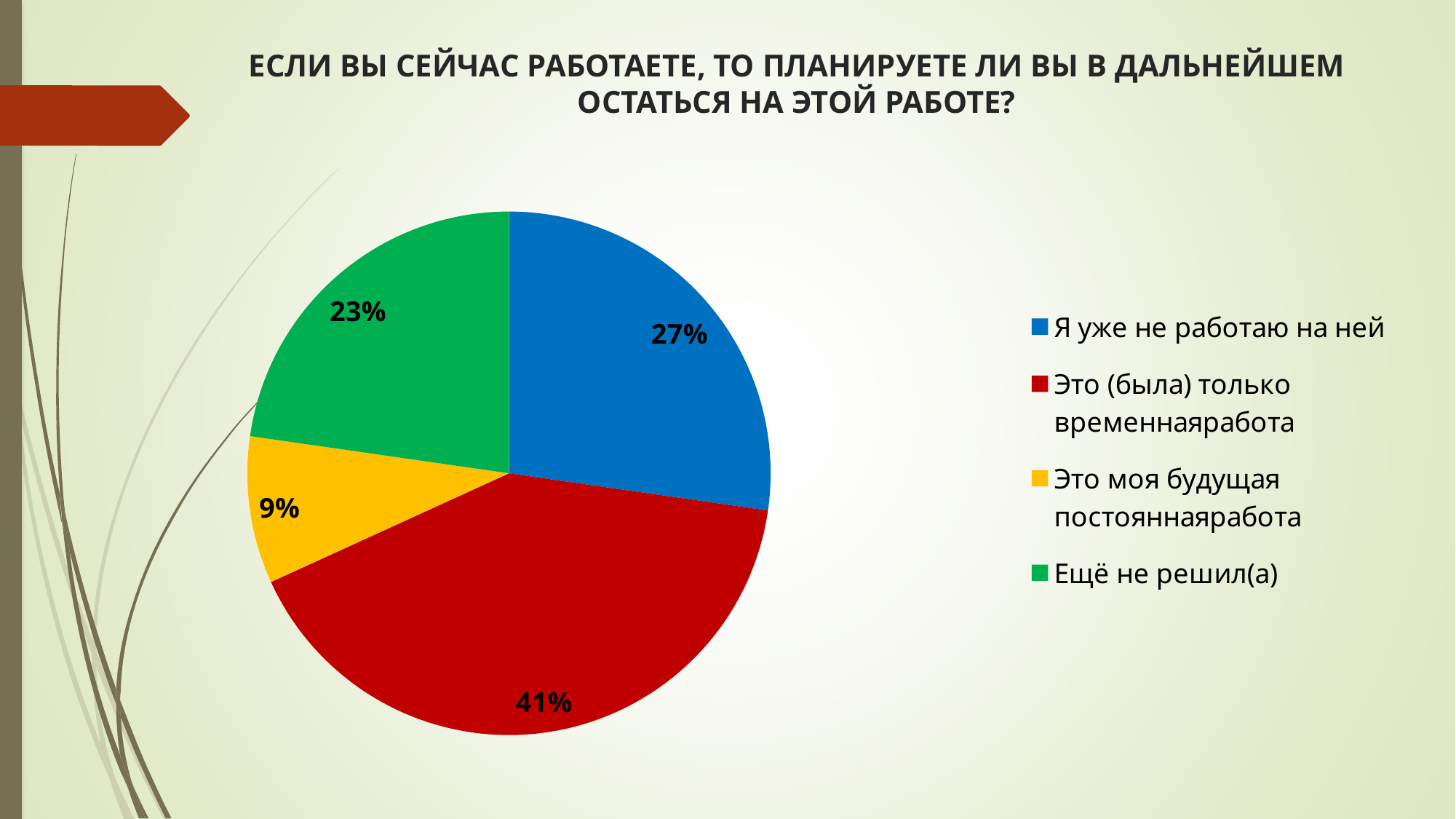
Which is larger: the share for "Ещё не решил(а)" or the share for "Я уже не работаю на ней"? Я уже не работаю на ней What colour is the slice for "Ещё не решил(а)"? green How many categories does the pie chart have? 4 What percentage is shown for "Это моя будущая постоянная работа"? 9% What percentage is shown for "Ещё не решил(а)"? 23% Which category has the largest share of the pie? Это (была) только временная работа What is the combined share of "Это моя будущая постоянная работа" and "Ещё не решил(а)"? 32% Which category has the smallest share of the pie? Это моя будущая постоянная работа What kind of chart is shown on the slide? pie chart What percentage is shown for "Я уже не работаю на ней"? 27% What percentage is shown for "Это (была) только временная работа"? 41% What is the difference between the shares for "Это (была) только временная работа" and "Я уже не работаю на ней"? 14%